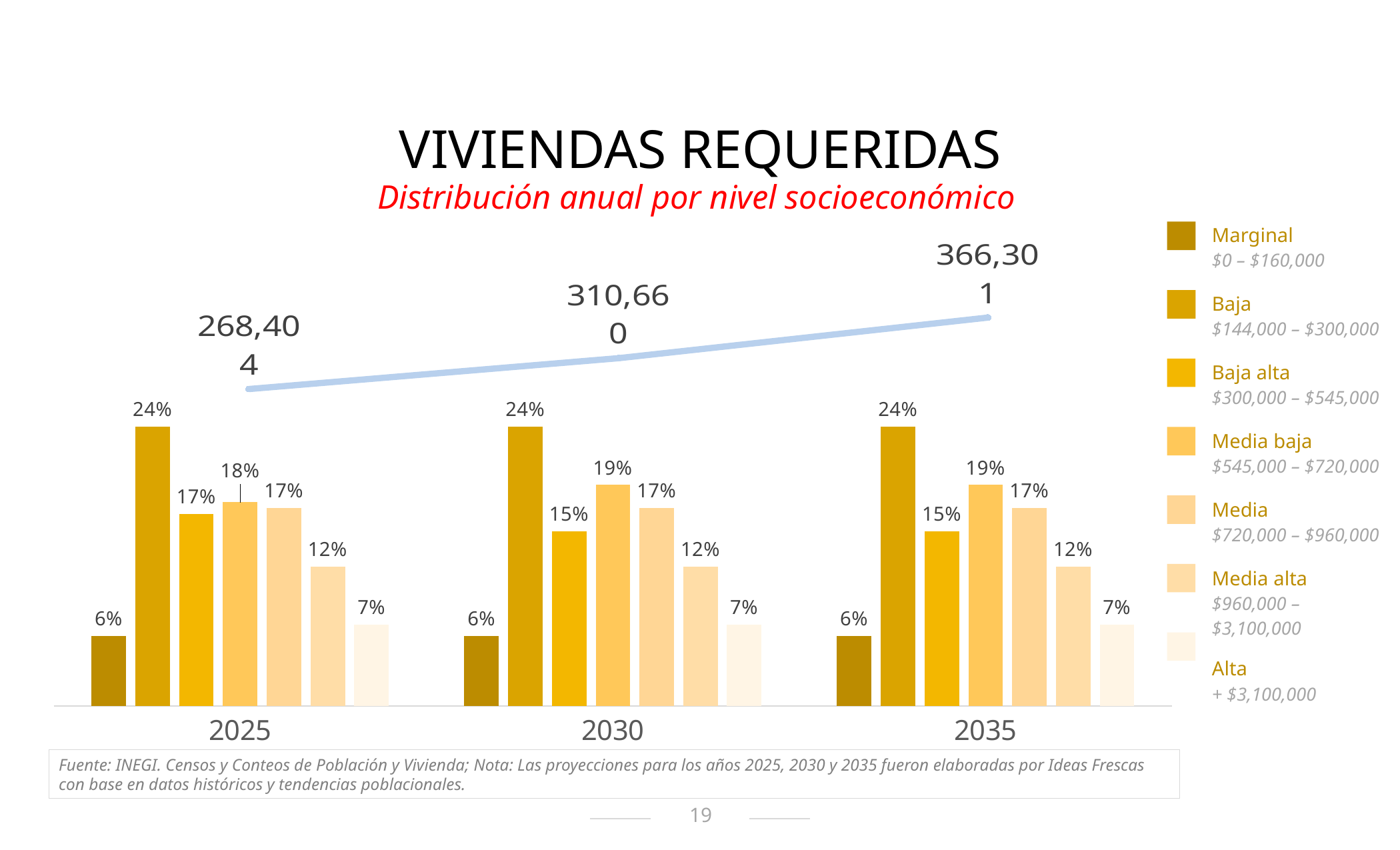
What is the value for Baja alta in 2035? 15% In 2025, which is larger: Baja alta or Media baja? Media baja What is the difference between the Baja and Alta shares in 2035? 17% What is the total number of viviendas requeridas shown for 2030? 310,660 Which socioeconomic level has the highest share in 2025? Baja What is the value for Media baja in 2030? 19% How many years are shown on the x axis? 3 How many socioeconomic levels does the legend list? 7 What kind of chart is used to show the distribution by socioeconomic level? bar chart Does the total line rise or fall from 2025 to 2035? rises Which socioeconomic level has the lowest share in 2030? Marginal What is the value for Baja in 2025? 24%